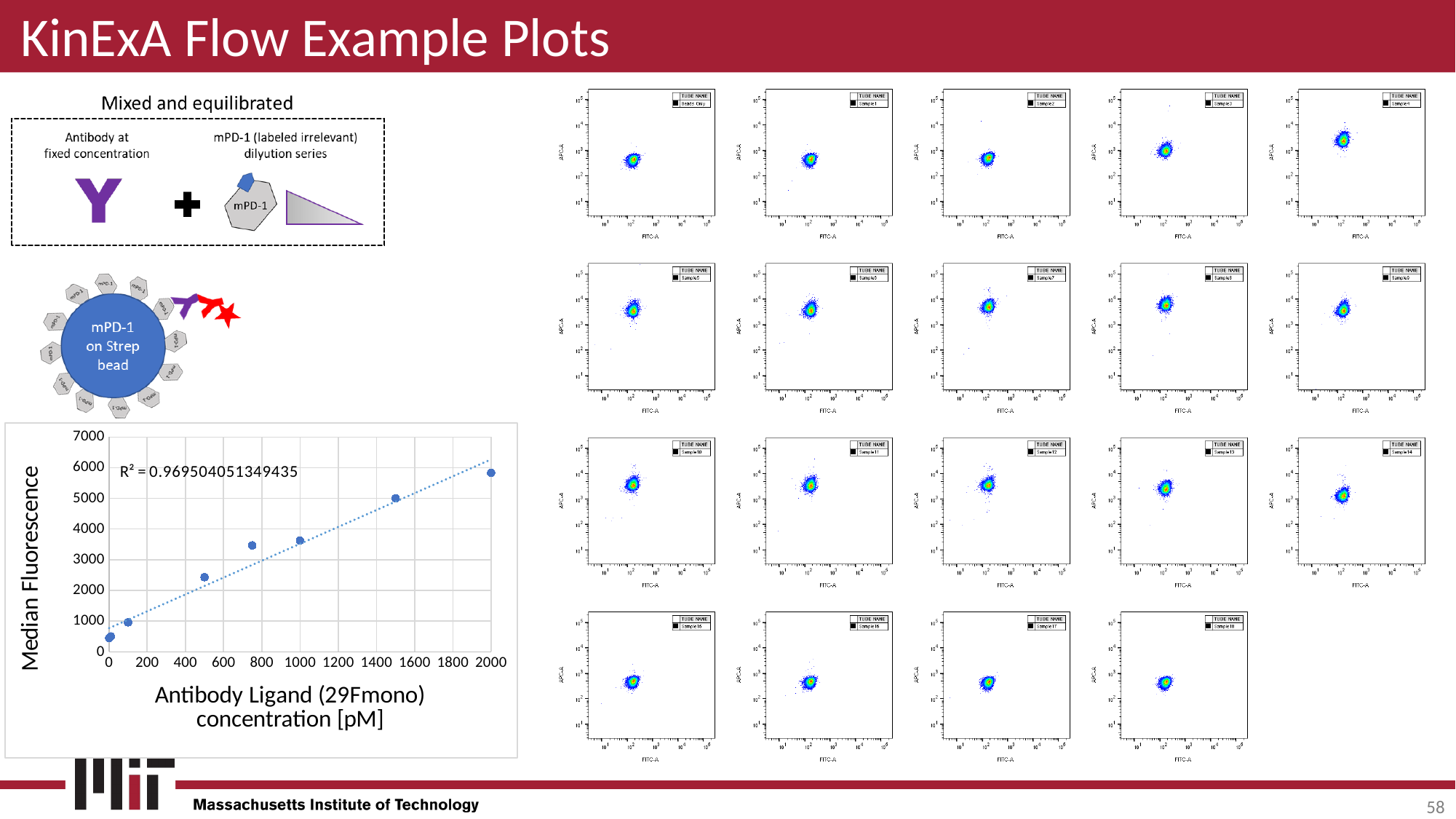
In the Median Fluorescence chart, is the value at 500 pM greater or less than 3000? less What kind of chart is the 'Median Fluorescence' chart on the left of the slide? scatter chart In the Median Fluorescence chart, is the value at 1500 pM greater or less than 4000? greater In the Median Fluorescence chart, is the value at 1000 pM greater or less than 4000? less In the Median Fluorescence chart, do the values rise or fall as the antibody ligand concentration increases? rise In the Median Fluorescence chart, which has the larger median fluorescence: the point at 1500 pM or the point at 750 pM? 1500 pM What is the y-axis title of the scatter chart on the left of the slide? Median Fluorescence In the Median Fluorescence chart, how many data points are plotted? 8 In the Median Fluorescence chart, at which concentration is the median fluorescence highest? 2000 What R² value is printed on the Median Fluorescence chart? R² = 0.969504051349435